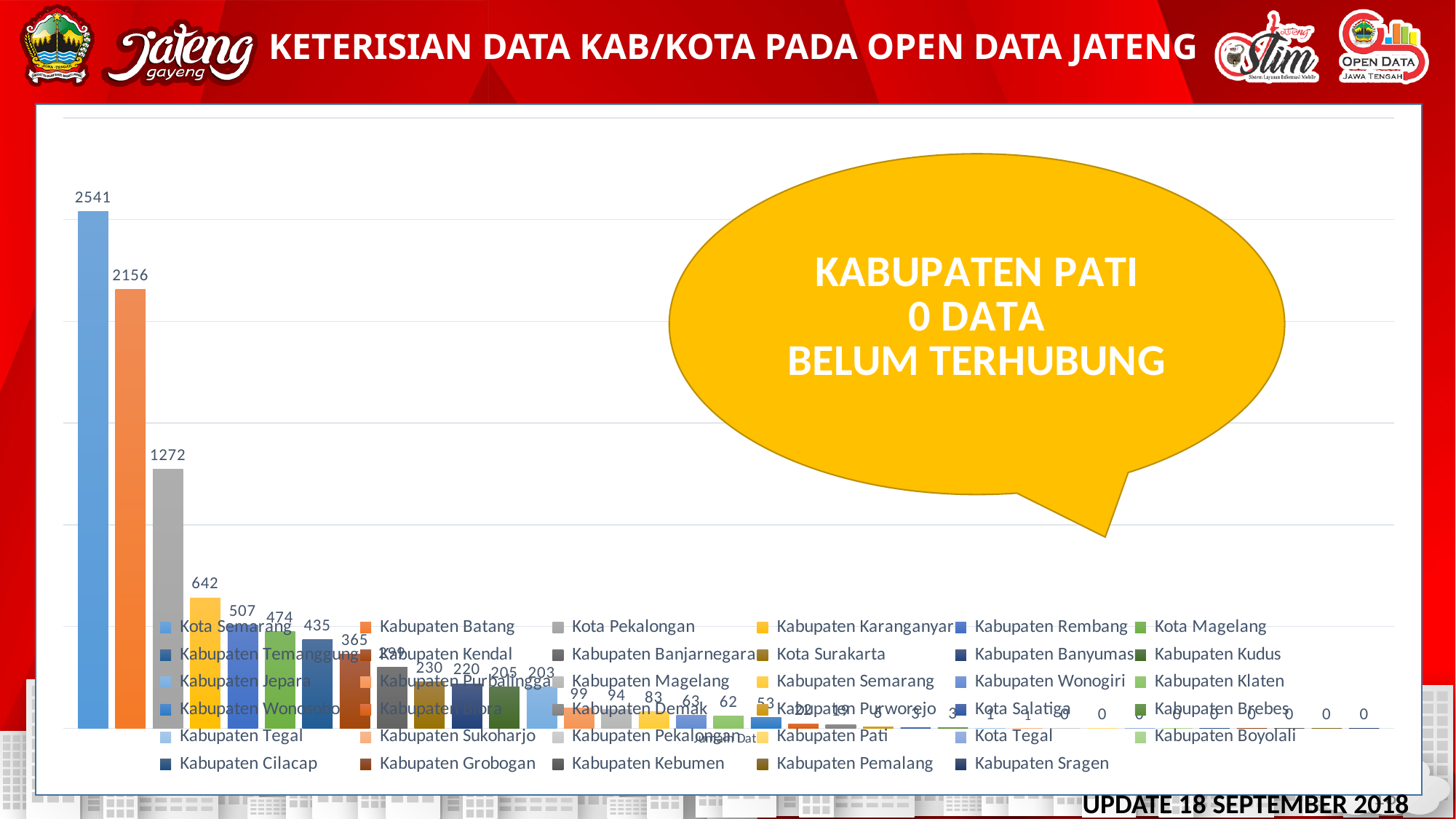
What is the value of the second-tallest bar on the chart? 2156 How many entries does the chart legend list? 35 Which is larger, the tallest bar at 2541 or the second bar at 2156? 2541 What is the value of the fourth-tallest bar on the chart? 642 What kind of chart is shown on the slide? bar chart What does the callout on the chart say about Kabupaten Pati's connection status? BELUM TERHUBUNG What is the difference between the two tallest bars (2541 and 2156)? 385 Do the bar values rise or fall from left to right along the x axis? fall According to the callout on the chart, how much data does Kabupaten Pati have? 0 What is the highest value shown by a data label on the chart? 2541 What is the lowest value shown by a data label on the chart? 0 What is the value of the third-tallest bar on the chart? 1272